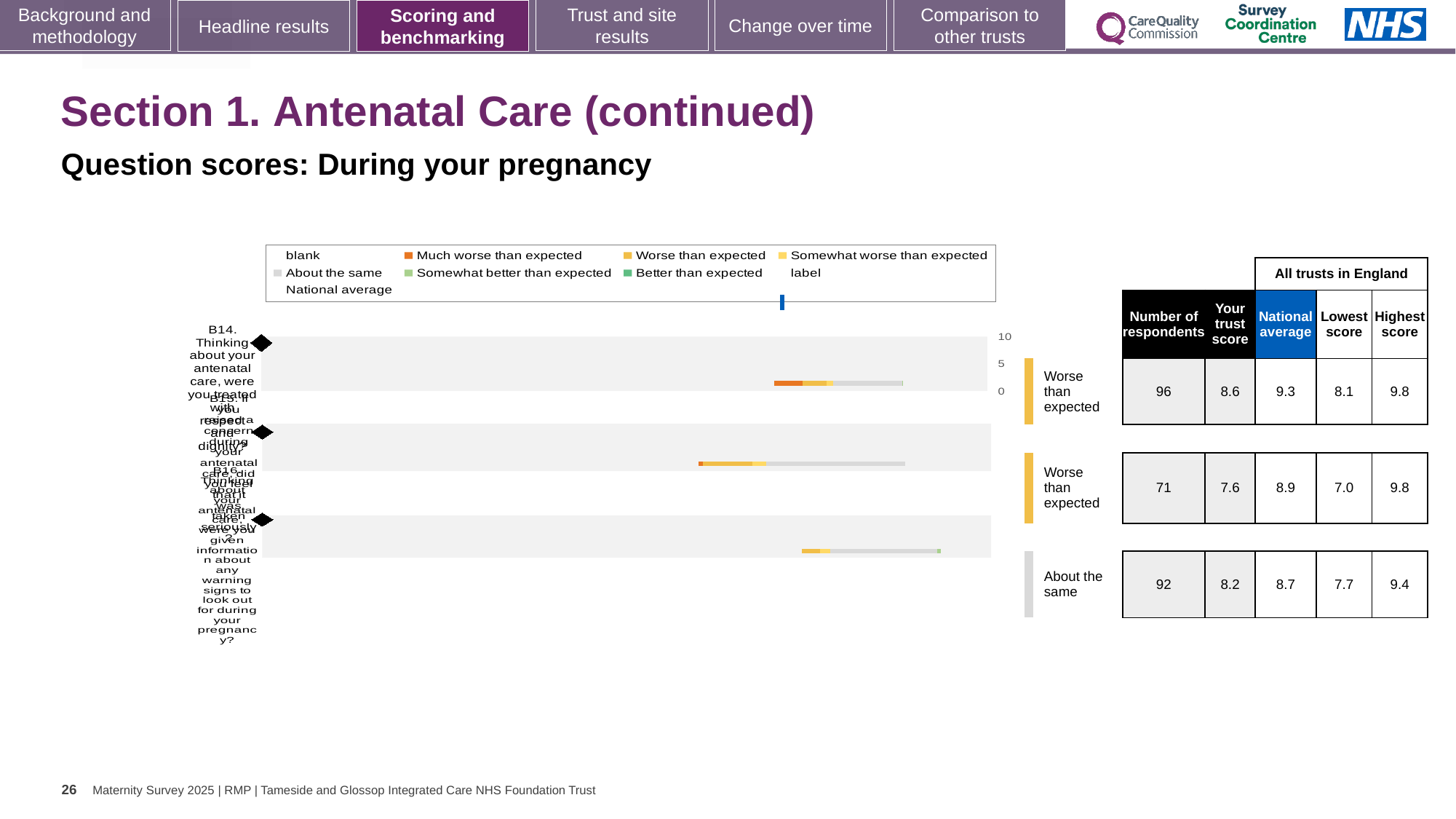
In the table beside the chart, what is the trust score for the second row? 7.6 In the table beside the chart, what is the difference between the national average and the trust score for the first row? 0.7 In the table beside the chart, what is the highest score for the second row? 9.8 In the table beside the chart, is the trust score for the third row larger or smaller than its national average? smaller In the table beside the chart, what is the number of respondents for the first row? 96 What kind of chart is shown on the slide? bar chart In the table beside the chart, which row has the lowest trust score? the second row (7.6) How many question rows (categories) are plotted in the chart? 3 What benchmark label is shown beside the first (top) row of the chart? Worse than expected In the table beside the chart, what is the national average for the third row? 8.7 What benchmark label is shown beside the third (bottom) row of the chart? About the same